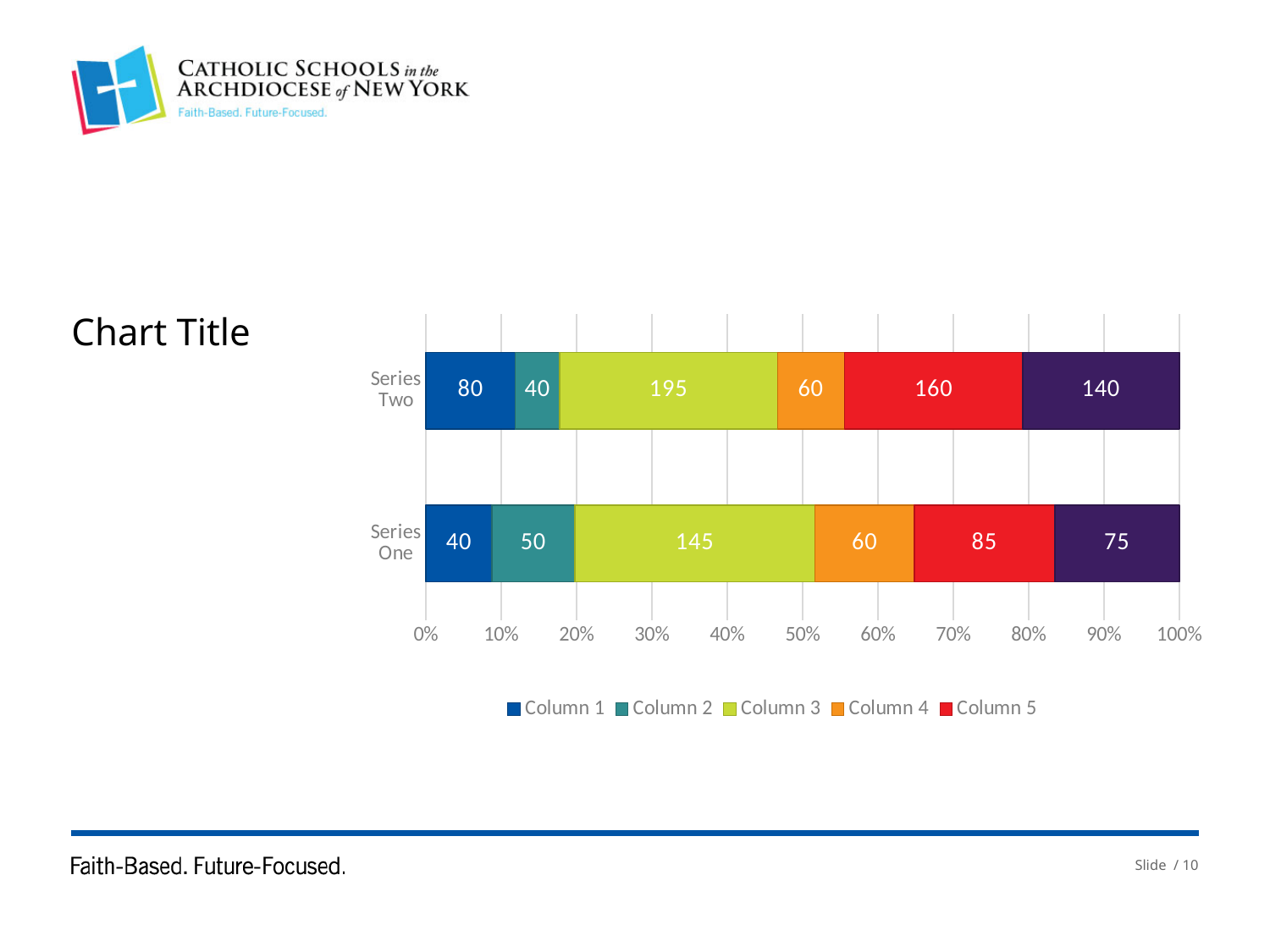
What type of chart is shown on the slide? Stacked bar chart Which has the larger Column 5 value, Series One or Series Two? Series Two Which legend column has the largest value in the Series One bar? Column 3 What is the value of Column 4 for Series Two? 60 What is the value of Column 5 for Series One? 85 What is the difference between the Column 3 values for Series Two and Series One? 50 How many entries does the legend list? 5 What is the value of Column 1 for Series One? 40 What is the total of all segments in the Series Two bar? 675 How many bars (categories) are shown in the chart? 2 What is the value of Column 3 for Series Two? 195 Which has the larger Column 2 value, Series One or Series Two? Series One